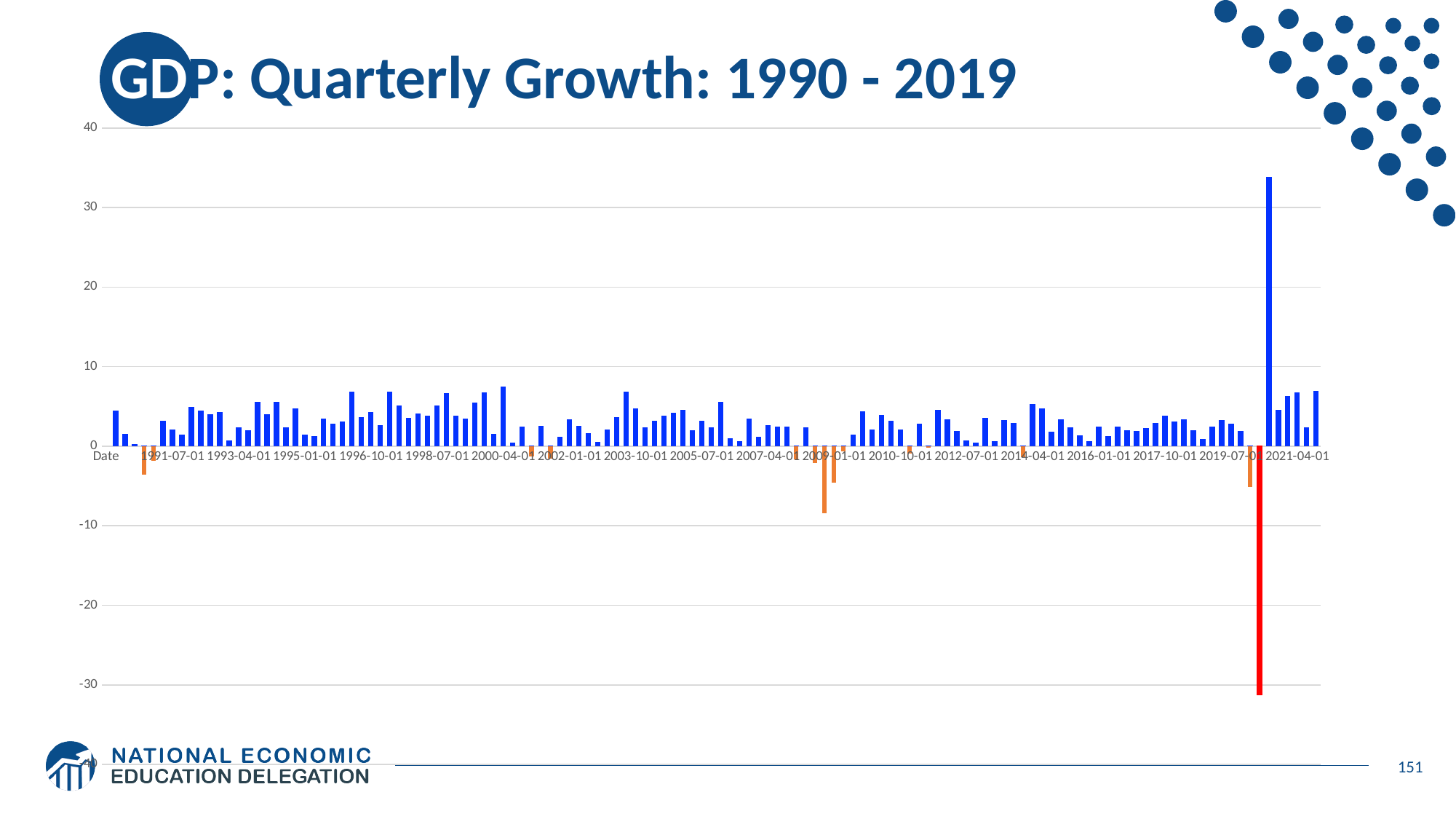
What colour is the single bar that drops below -30? red Which is larger in magnitude: the tallest positive bar near 2021 or the deepest negative bar near 2009-01-01? the tallest positive bar near 2021 What is the title of the chart? GDP: Quarterly Growth: 1990 - 2019 What kind of chart is shown on the slide? bar chart Is the value of the lowest bar (the red bar near 2020) greater or less than -30? less Is the value of the tallest bar (the blue spike near 2021) greater or less than 30? greater What is the highest value shown on the vertical axis? 40 Is the value of the tallest bar greater or less than 40? less